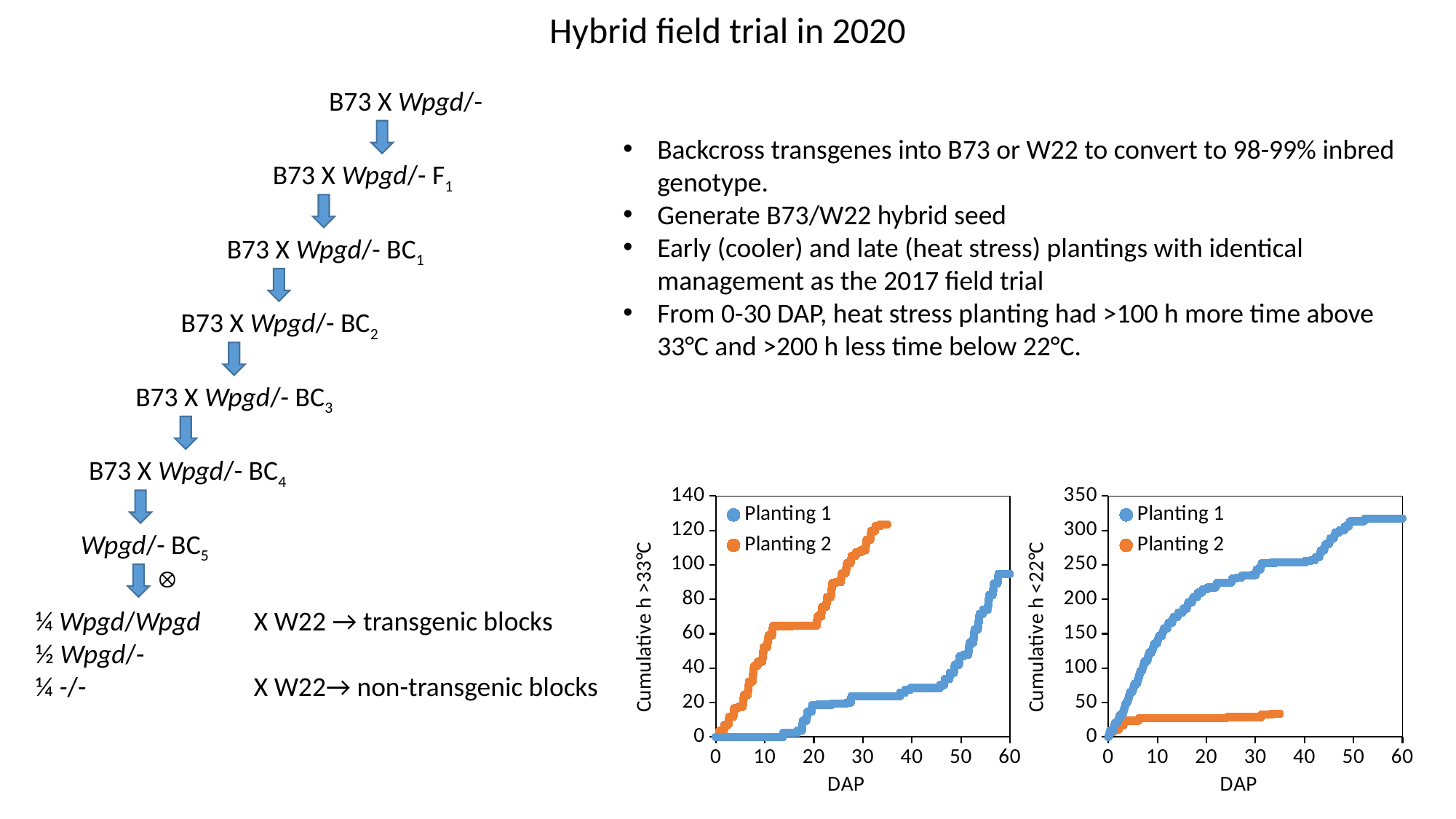
In the left chart (Cumulative h >33°C), is the value for Planting 1 at 40 DAP greater or less than 40? less In the right chart (Cumulative h <22°C), is the value for Planting 1 at 20 DAP greater or less than 150? greater In the right chart (Cumulative h <22°C), which series has the larger value at 30 DAP, Planting 1 or Planting 2? Planting 1 In the right chart (Cumulative h <22°C), do the values for Planting 1 rise or fall as DAP increases? rise In the left chart (Cumulative h >33°C), is the value for Planting 2 at 30 DAP greater or less than 100? greater What kind of chart is the left chart (Cumulative h >33°C)? scatter chart What is the x-axis label of the left chart? DAP In the left chart (Cumulative h >33°C), which series has the larger value at 30 DAP, Planting 1 or Planting 2? Planting 2 How many series does the legend of the right chart (Cumulative h <22°C) list? 2 What colour represents Planting 2 in the charts? orange